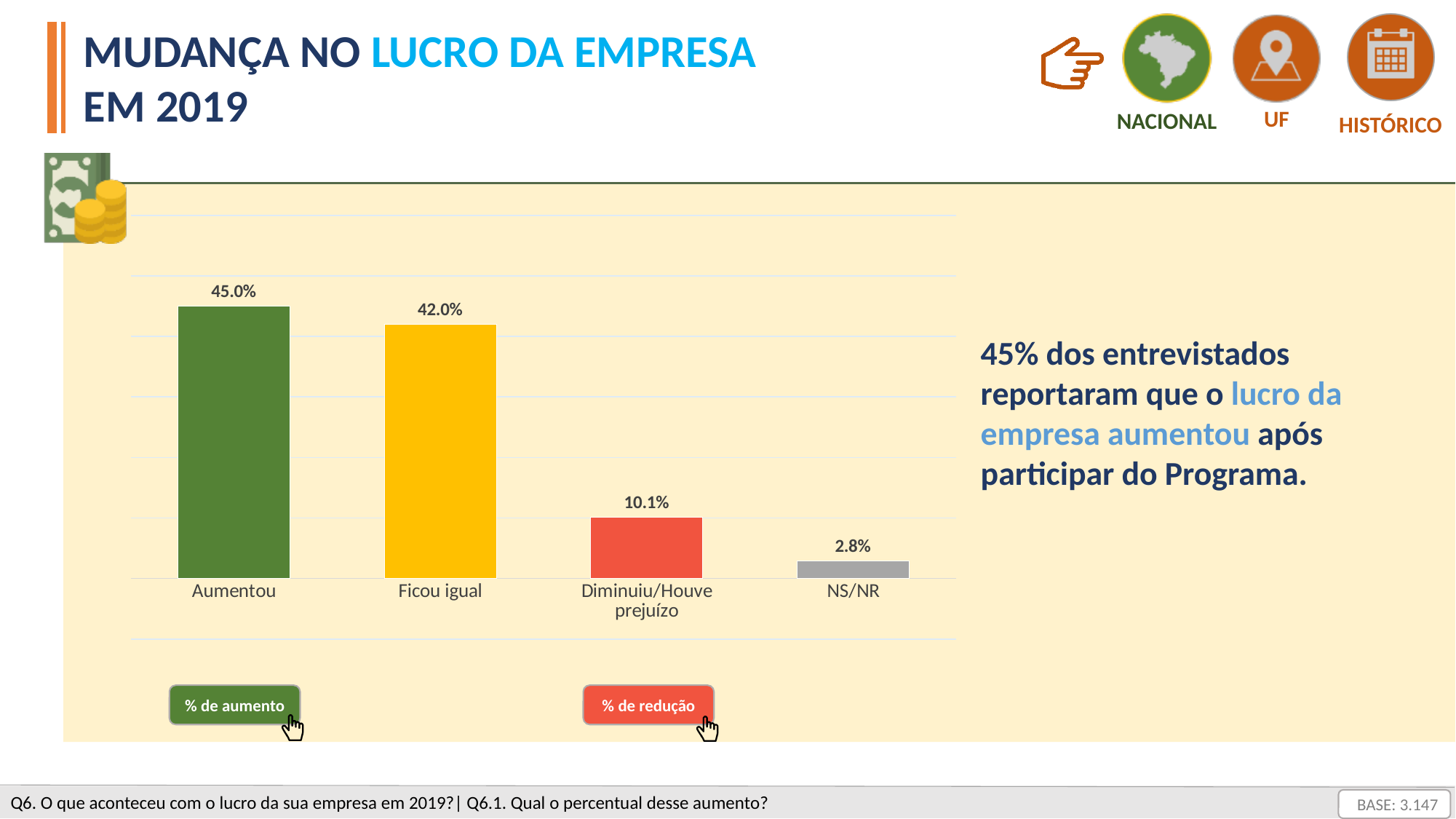
What is the value for NS/NR? 2.8% What is the difference between the values for Diminuiu/Houve prejuízo and NS/NR? 7.3% Which category has the lowest value? NS/NR What colour is the bar for Diminuiu/Houve prejuízo? Red What is the value for Ficou igual? 42.0% How many categories are shown in the chart? 4 What is the difference between the values for Aumentou and Ficou igual? 3.0% What kind of chart is shown on the slide? Bar chart What is the value for Aumentou? 45.0% Which is larger, the value for Ficou igual or the value for Diminuiu/Houve prejuízo? Ficou igual Which category has the highest value? Aumentou What is the value for Diminuiu/Houve prejuízo? 10.1%